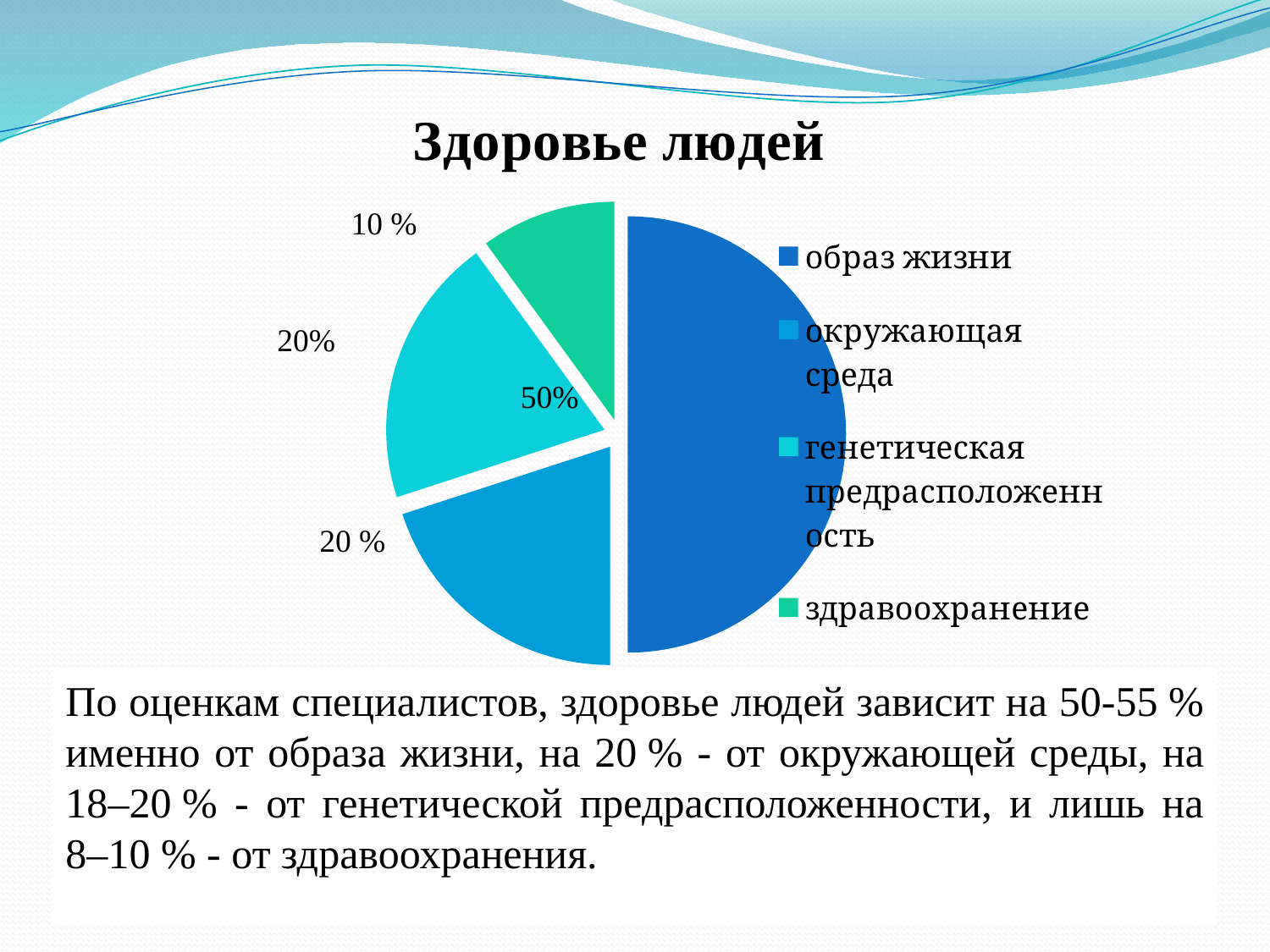
Which category has the smallest slice of the pie? здравоохранение What is the difference in percentage points between "образ жизни" and "здравоохранение"? 40 What is the value shown for "генетическая предрасположенность"? 20% Which category has the largest slice of the pie? образ жизни How many entries does the legend list? 4 What is the title of the chart? Здоровье людей What is the value shown for "окружающая среда"? 20 % How many slices does the pie chart have? 4 Which is larger, the slice for "образ жизни" or the slice for "здравоохранение"? образ жизни What is the value shown for "здравоохранение"? 10 % What share of the pie does "образ жизни" take? 50% What kind of chart is shown on the slide? pie chart